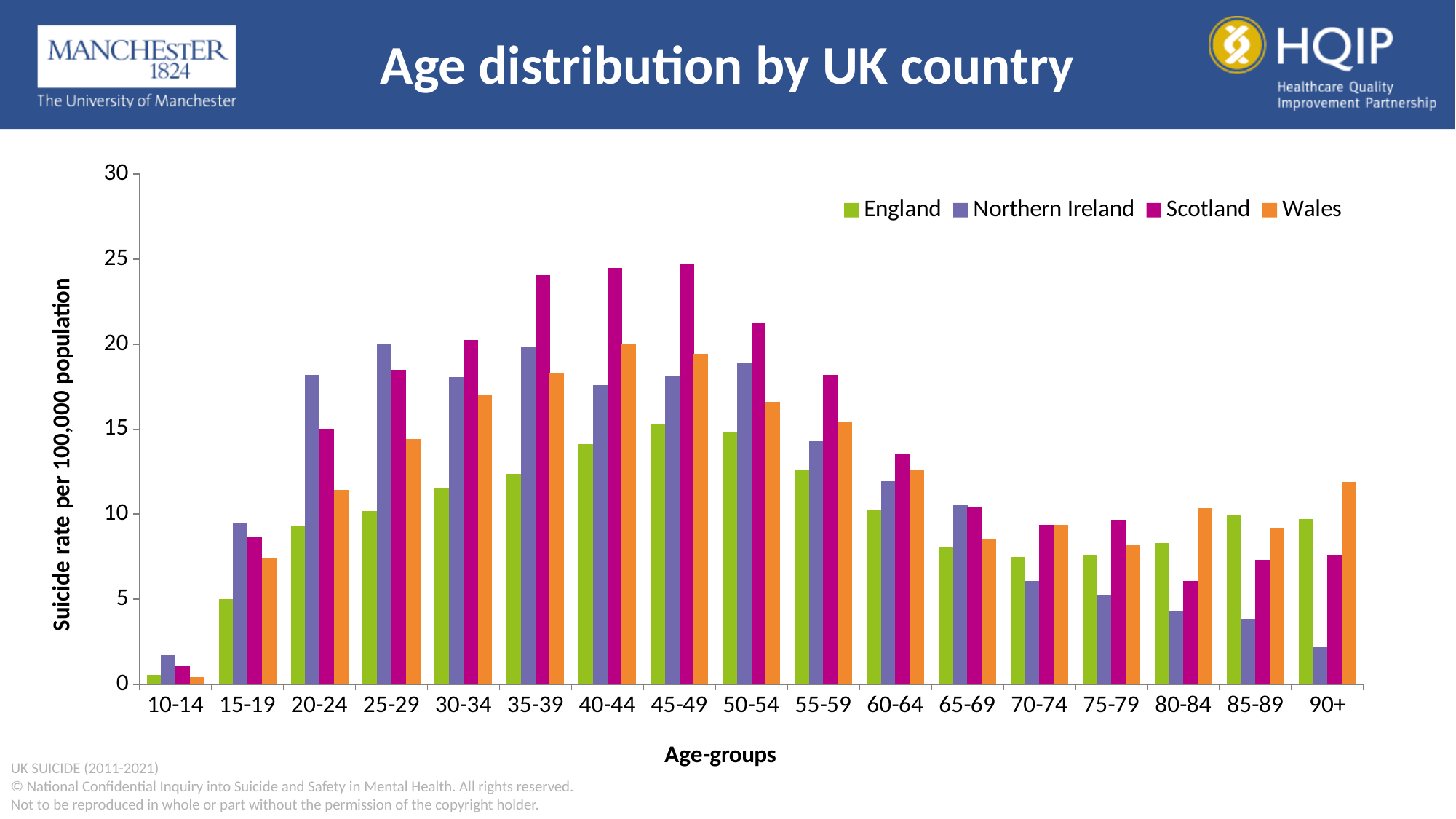
Which age group has the lowest suicide rate for England? 10-14 How many age-group categories are shown on the x axis? 17 How many series does the legend list? 4 In the 20-24 age group, which is larger: the value for Northern Ireland or the value for Scotland? Northern Ireland What kind of chart is shown on the slide? bar chart Is the value for Northern Ireland in the 90+ age group greater or less than 5? less Is the value for Scotland in the 45-49 age group greater or less than 20? greater Does the value for Northern Ireland rise or fall from the 50-54 age group to the 90+ age group? fall Which country has the highest suicide rate in the 45-49 age group? Scotland What is the title of the y axis? Suicide rate per 100,000 population In the 85-89 age group, which is larger: the value for England or the value for Northern Ireland? England Which country has the highest suicide rate in the 90+ age group? Wales